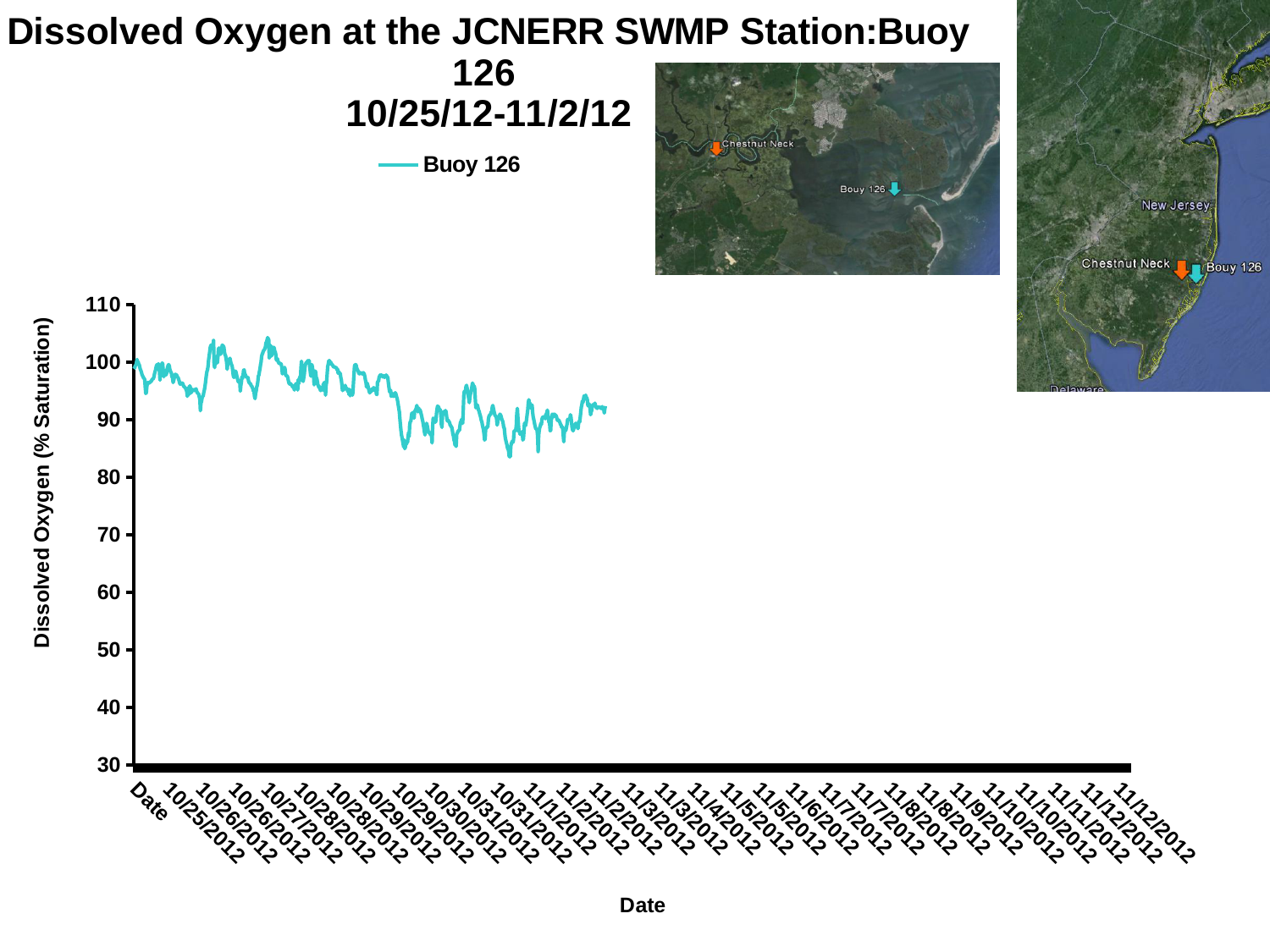
What is the name of the series shown in the chart legend? Buoy 126 What is the lowest tick value shown on the vertical axis? 30 What is the highest tick value shown on the vertical axis? 110 Are all plotted dissolved oxygen values greater or less than 80? greater Is the dissolved oxygen value around 11/1/2012 greater or less than 100? less Are all plotted dissolved oxygen values greater or less than 110? less What kind of chart is shown on the slide? line chart Overall, do the dissolved oxygen values rise or fall from 10/25/2012 to 11/2/2012? fall How many series does the chart legend list? 1